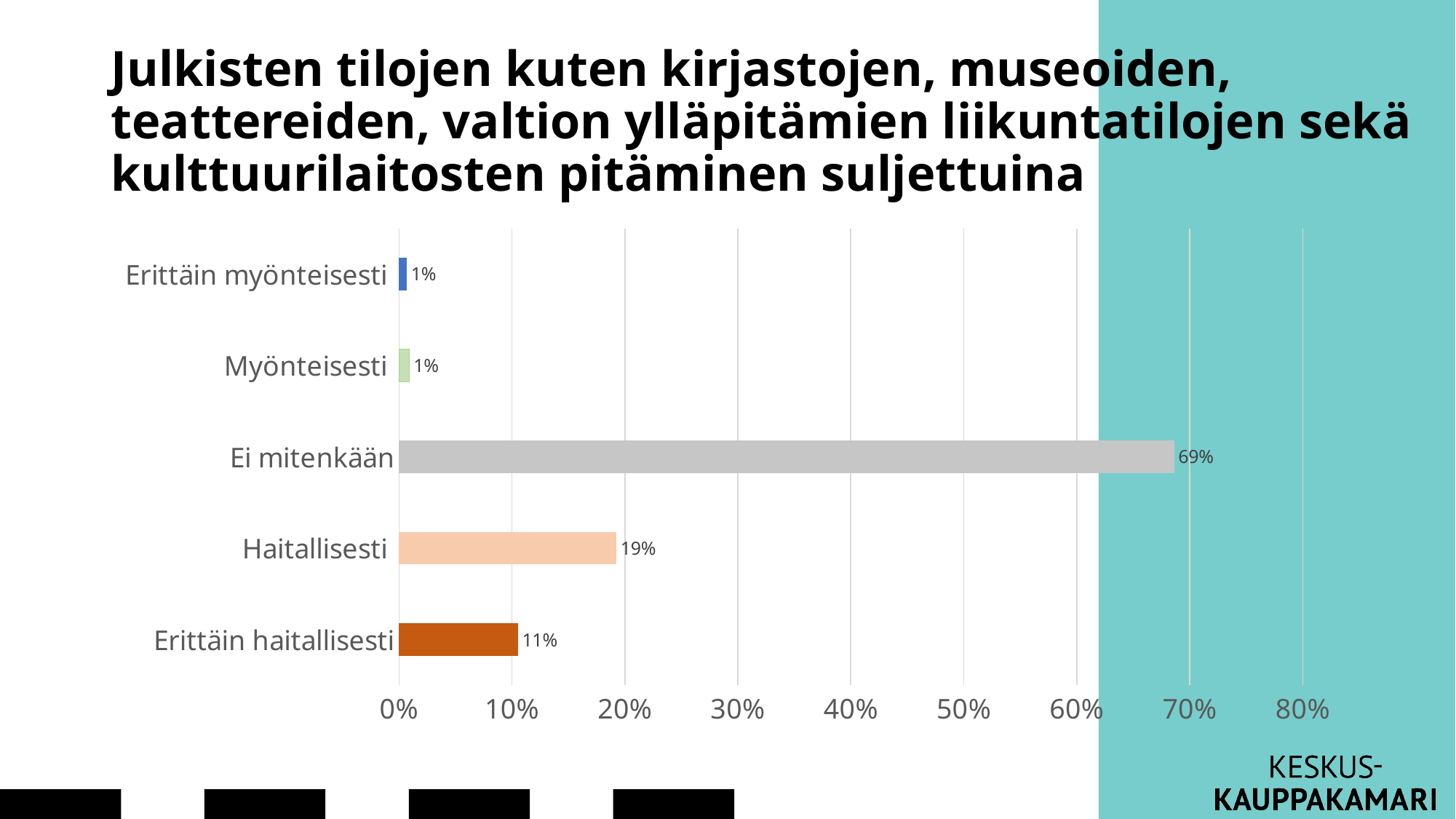
What is the value for Ei mitenkään? 69% What is the value for Haitallisesti? 19% What is the value for Myönteisesti? 1% What is the value for Erittäin haitallisesti? 11% What is the difference between the values for Ei mitenkään and Haitallisesti? 50% What is the combined value of Haitallisesti and Erittäin haitallisesti? 30% Which category has the highest value? Ei mitenkään What kind of chart is shown on the slide? bar chart Is the value for Ei mitenkään greater or less than 60%? greater What is the difference between the values for Haitallisesti and Erittäin haitallisesti? 8% How many categories are shown in the chart? 5 Which is larger, the value for Haitallisesti or the value for Erittäin haitallisesti? Haitallisesti